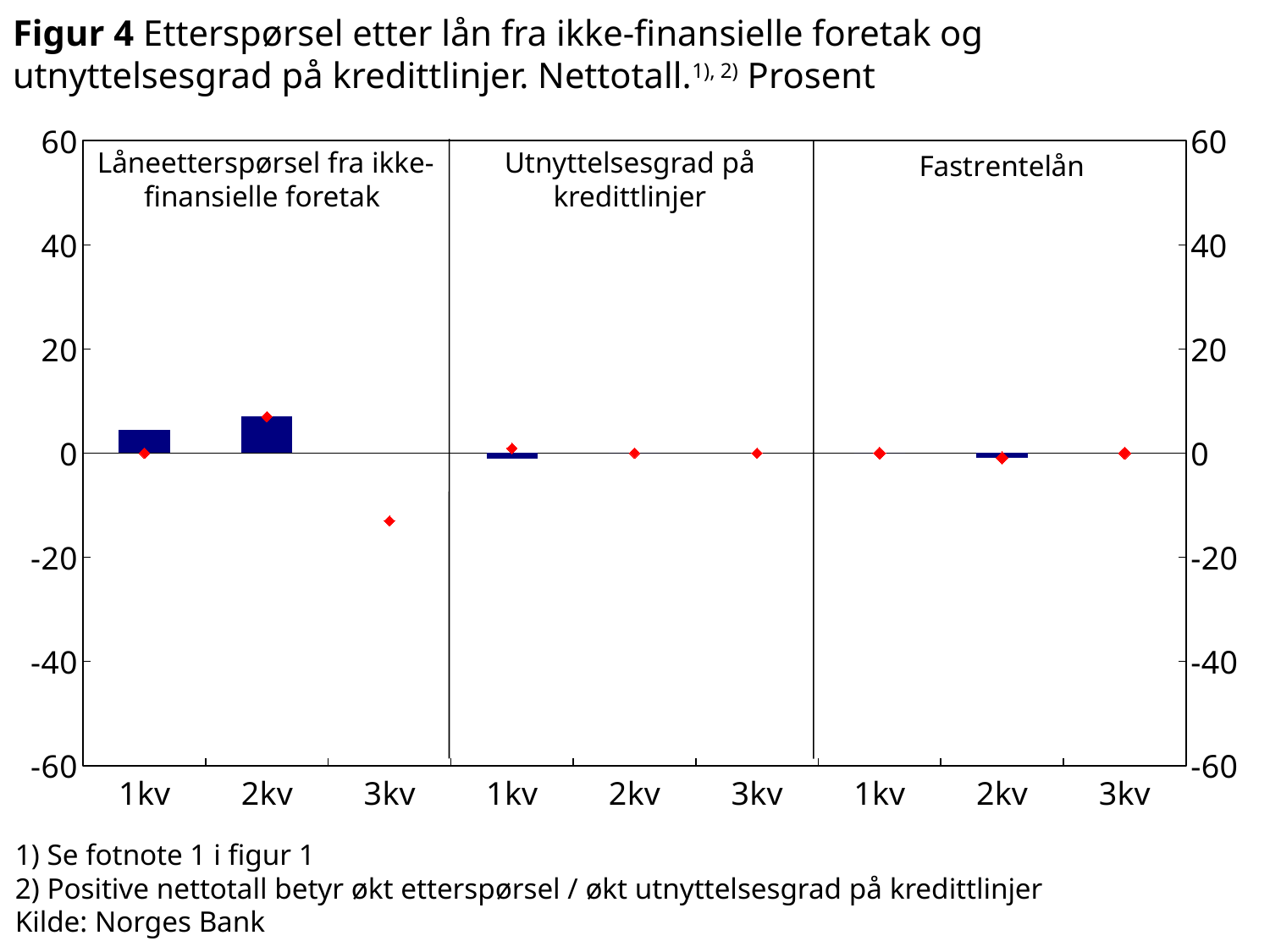
How many panels (sections) does the chart have? 3 In the panel 'Låneetterspørsel fra ikke-finansielle foretak', is the red diamond for 3kv greater or less than 0? less In the panel 'Låneetterspørsel fra ikke-finansielle foretak', which bar is larger, 1kv or 2kv? 2kv In the panel 'Låneetterspørsel fra ikke-finansielle foretak', is the bar for 1kv greater or less than 0? greater How many quarters are shown on the x axis in each panel? 3 What is the title of the third panel of the chart? Fastrentelån In the panel 'Låneetterspørsel fra ikke-finansielle foretak', which quarter has the tallest bar? 2kv What kind of chart is shown on the slide? combination bar and line chart (bars with red diamond markers) In the panel 'Låneetterspørsel fra ikke-finansielle foretak', is the red diamond for 3kv greater or less than -20? greater What is the source given for the chart? Norges Bank What is the maximum value shown on the y axis? 60